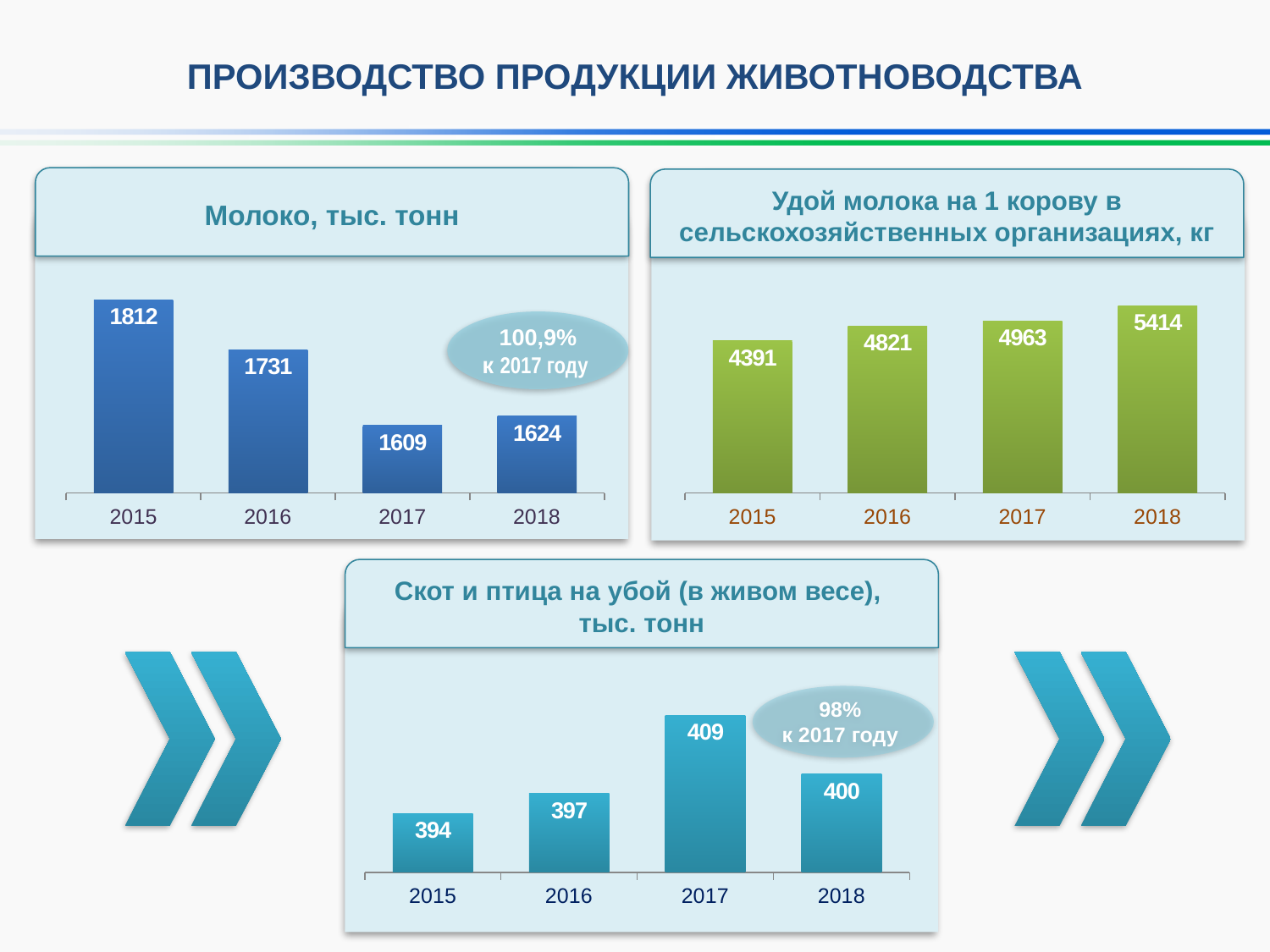
In the chart 'Скот и птица на убой (в живом весе), тыс. тонн', which is larger, the value for 2016 or the value for 2018? 2018 In the chart 'Молоко, тыс. тонн', what is the difference between the 2015 and 2018 values? 188 In the chart 'Молоко, тыс. тонн', what percentage relative to 2017 is shown in the callout? 100,9% In the chart 'Удой молока на 1 корову в сельскохозяйственных организациях, кг', what is the difference between the 2018 and 2017 values? 451 In the chart 'Молоко, тыс. тонн', which year has the lowest value? 2017 In the chart 'Скот и птица на убой (в живом весе), тыс. тонн', what is the value for 2017? 409 In the chart 'Удой молока на 1 корову в сельскохозяйственных организациях, кг', which year has the highest value? 2018 In the chart 'Молоко, тыс. тонн', what is the value for 2015? 1812 What type of chart is 'Молоко, тыс. тонн'? bar chart In the chart 'Удой молока на 1 корову в сельскохозяйственных организациях, кг', what is the value for 2016? 4821 In the chart 'Удой молока на 1 корову в сельскохозяйственных организациях, кг', do the values rise or fall from 2015 to 2018? rise In the chart 'Скот и птица на убой (в живом весе), тыс. тонн', how many years are shown? 4